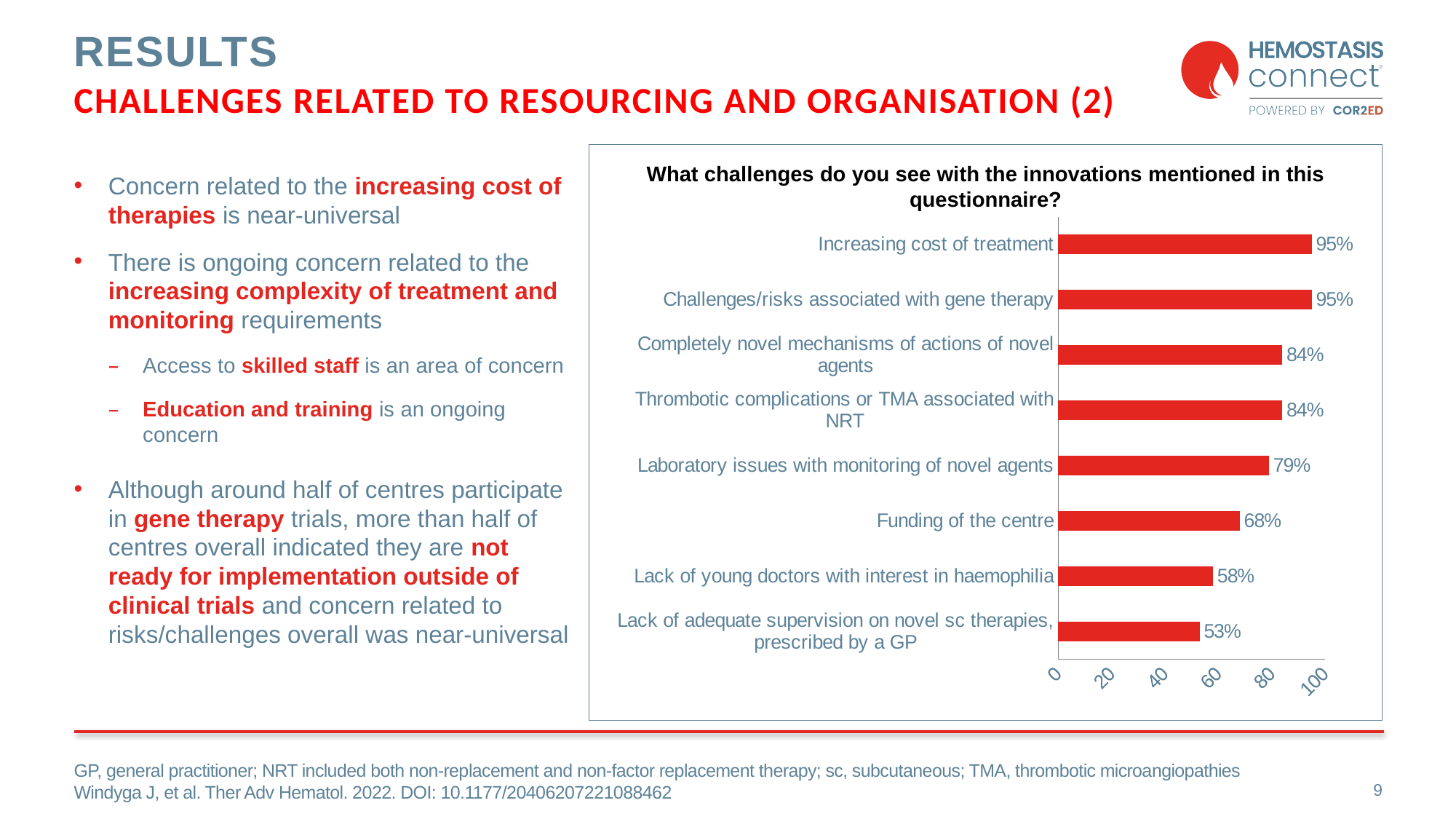
What is the value for "Increasing cost of treatment"? 95% What is the value for "Funding of the centre"? 68% What is the value for "Lack of young doctors with interest in haemophilia"? 58% Which category has the lowest value? Lack of adequate supervision on novel sc therapies, prescribed by a GP Is the value for "Lack of adequate supervision on novel sc therapies, prescribed by a GP" greater or less than 60? less What is the difference between the values for "Laboratory issues with monitoring of novel agents" and "Lack of young doctors with interest in haemophilia"? 21% What kind of chart is shown on the slide? bar chart Which is larger: the value for "Funding of the centre" or the value for "Thrombotic complications or TMA associated with NRT"? Thrombotic complications or TMA associated with NRT What is the value for "Laboratory issues with monitoring of novel agents"? 79% How many categories are shown in the chart? 8 What is the title of the chart? What challenges do you see with the innovations mentioned in this questionnaire? What is the difference between the values for "Increasing cost of treatment" and "Funding of the centre"? 27%